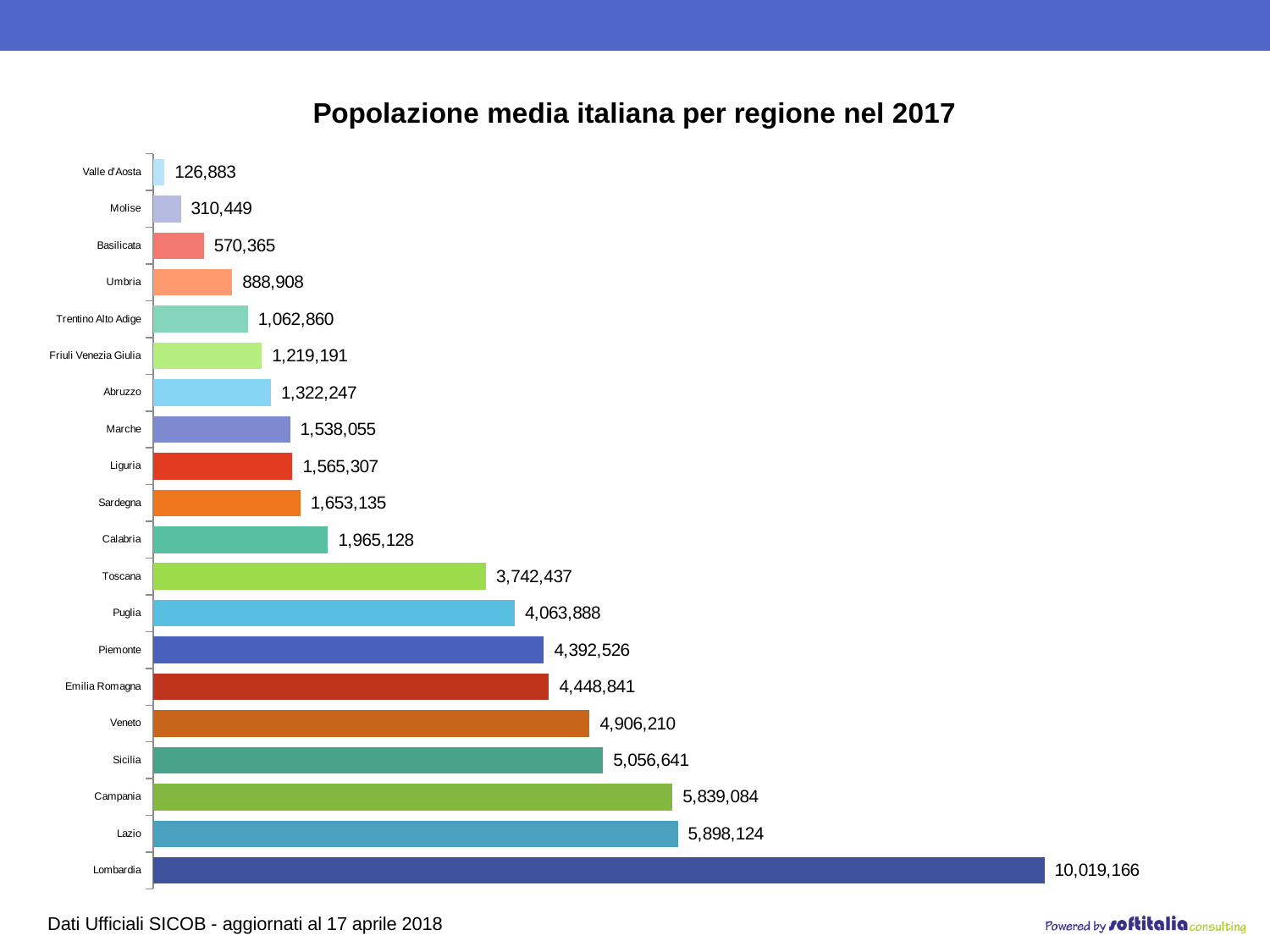
What is the value for Valle d'Aosta? 126,883 What is the difference between the values for Molise and Valle d'Aosta? 183,566 What is the value for Sardegna? 1,653,135 What is the difference between the values for Lombardia and Lazio? 4,121,042 Which region has the highest value? Lombardia How many regions are shown in the chart? 20 What is the title of the chart? Popolazione media italiana per regione nel 2017 What is the value for Toscana? 3,742,437 Which region has the lowest value? Valle d'Aosta What kind of chart is shown on the slide? Bar chart Which is larger, the value for Puglia or the value for Toscana? Puglia What is the value for Lombardia? 10,019,166